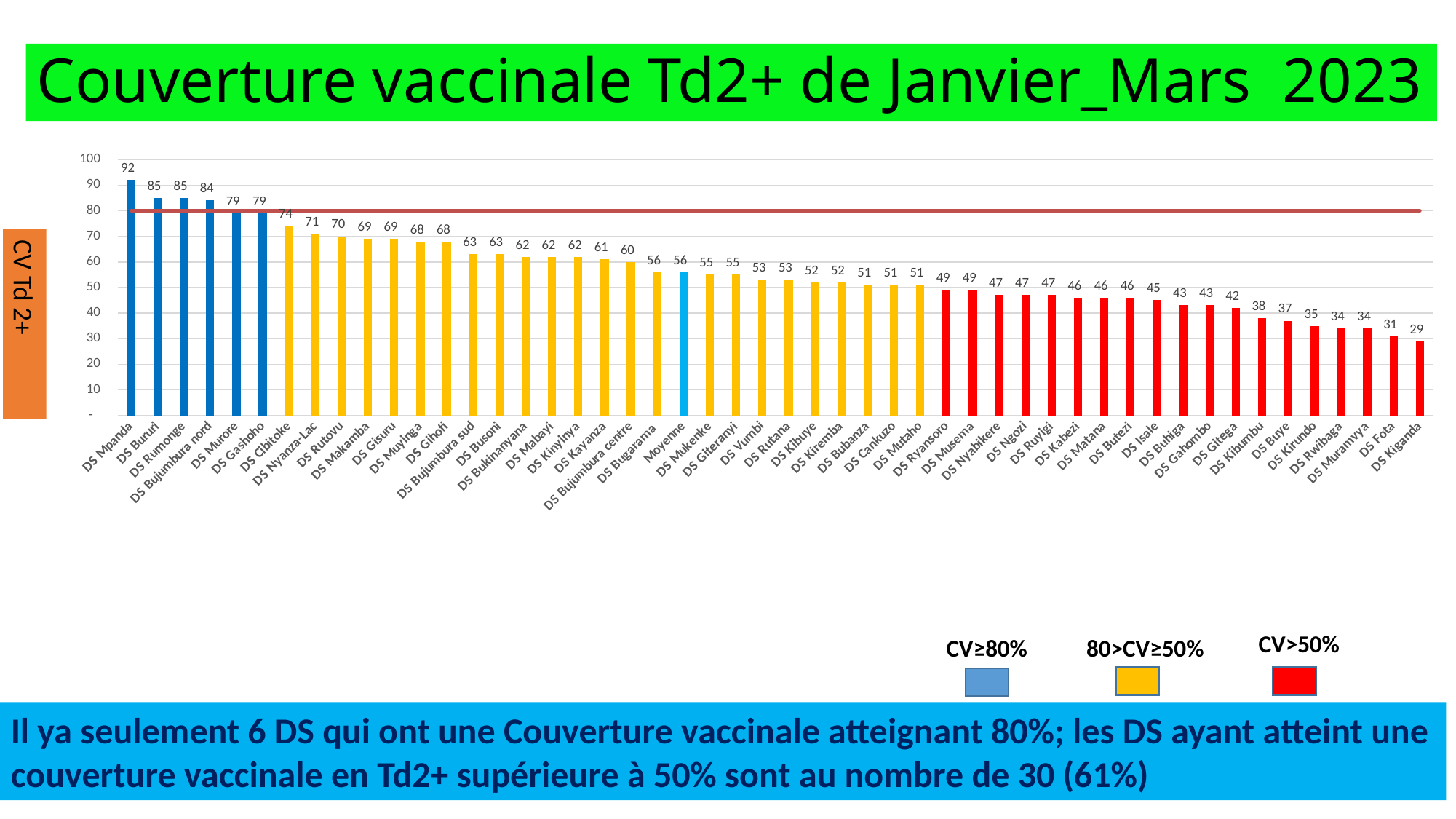
Which district has the highest Td2+ coverage? DS Mpanda Do the values rise or fall from left to right along the x axis? Fall What value does the horizontal red reference line mark on the y axis? 80 What type of chart is shown on the slide? Bar chart What is the value shown for Moyenne? 56 What is the value for DS Cibitoke? 74 What is the difference between the values for DS Mpanda and DS Kiganda? 63 Which district has the lowest Td2+ coverage? DS Kiganda What is the value for DS Mpanda? 92 What is the value for DS Kiganda? 29 How many bars are coloured dark blue (CV≥80%)? 6 Which is larger, the value for DS Gitega or the value for DS Kibumbu? DS Gitega